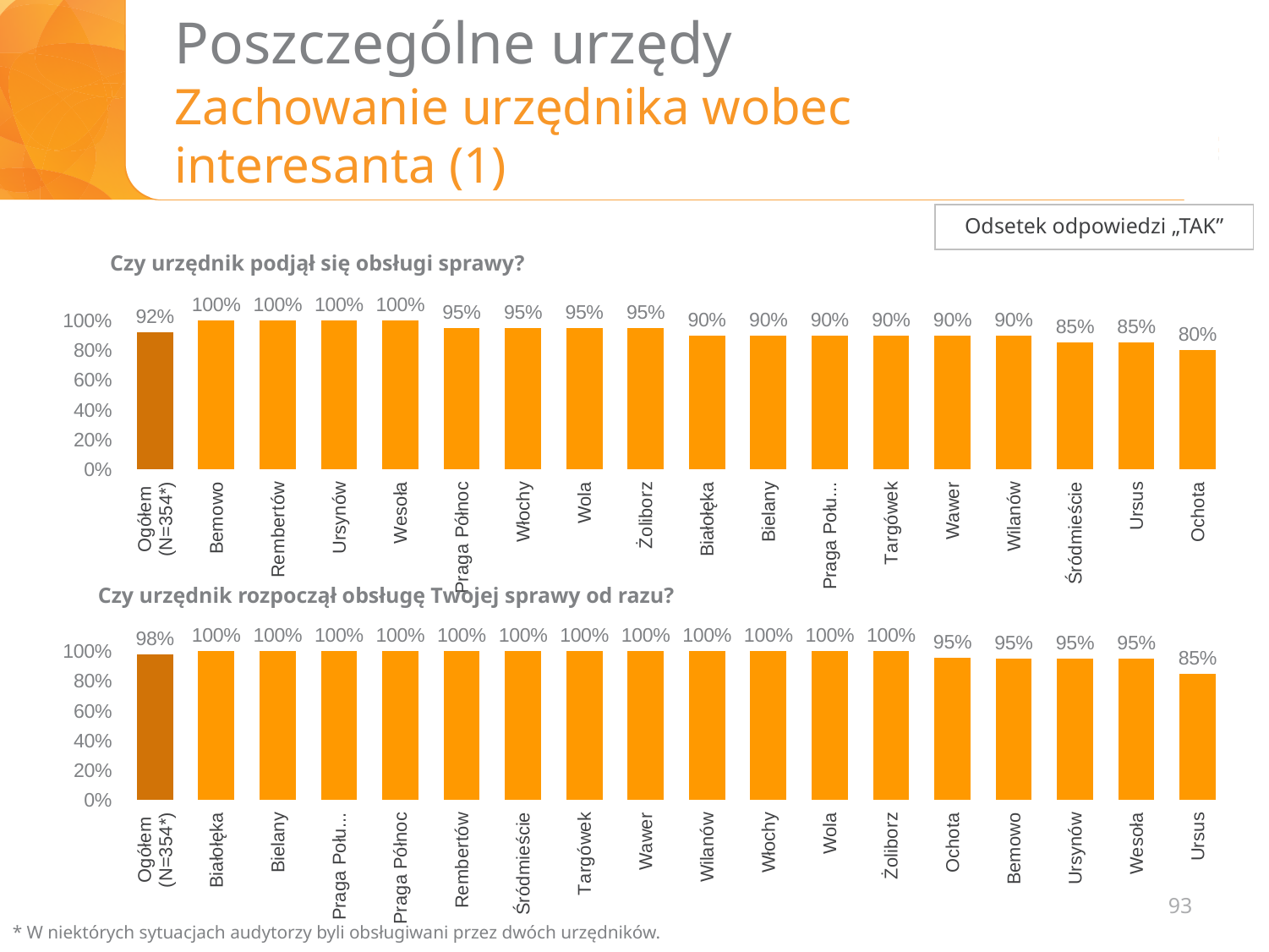
In the bottom chart ("Czy urzędnik rozpoczął obsługę Twojej sprawy od razu?"), what is the value for Ursus? 85% In the bottom chart ("Czy urzędnik rozpoczął obsługę Twojej sprawy od razu?"), which category has the lowest value? Ursus In the top chart ("Czy urzędnik podjął się obsługi sprawy?"), how many bars are plotted? 18 In the top chart ("Czy urzędnik podjął się obsługi sprawy?"), what is the value for Ochota? 80% In the top chart ("Czy urzędnik podjął się obsługi sprawy?"), which category has the lowest value? Ochota What kind of chart is the bottom chart ("Czy urzędnik rozpoczął obsługę Twojej sprawy od razu?")? Bar chart In the top chart ("Czy urzędnik podjął się obsługi sprawy?"), what is the difference between the values for Bemowo and Ursus? 15% In the bottom chart ("Czy urzędnik rozpoczął obsługę Twojej sprawy od razu?"), do the values rise or fall from left to right after the Ogółem bar? Fall In the bottom chart ("Czy urzędnik rozpoczął obsługę Twojej sprawy od razu?"), what is the difference between the values for Białołęka and Ochota? 5% In the bottom chart ("Czy urzędnik rozpoczął obsługę Twojej sprawy od razu?"), what is the value for Ogółem (N=354*)? 98% In the top chart ("Czy urzędnik podjął się obsługi sprawy?"), what is the value for Ogółem (N=354*)? 92% In the top chart ("Czy urzędnik podjął się obsługi sprawy?"), which is larger, the value for Wola or the value for Wawer? Wola